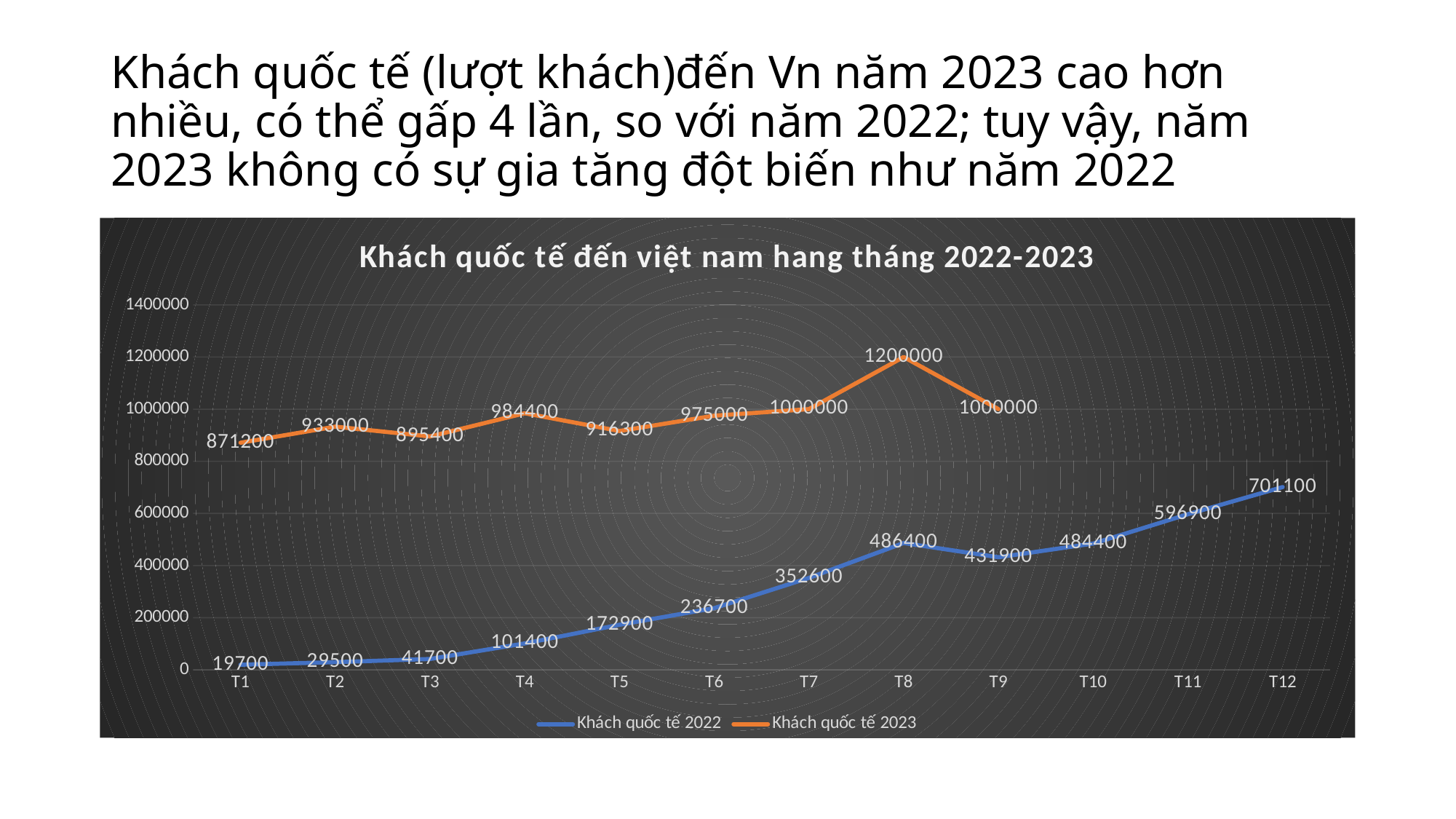
What is the value for Khách quốc tế 2022 in T12? 701100 Is the value for Khách quốc tế 2023 in T1 greater or less than 800000? greater Does Khách quốc tế 2022 generally rise or fall from T1 to T12? Rise What type of chart is shown on the slide? Line chart What is the value for Khách quốc tế 2023 in T4? 984400 What is the difference between Khách quốc tế 2023 and Khách quốc tế 2022 in T8? 713600 How many series does the legend list? 2 Which is larger: Khách quốc tế 2022 in T9 or in T10? T10 In which month does Khách quốc tế 2023 reach its highest value? T8 What is the title of the chart? Khách quốc tế đến việt nam hang tháng 2022-2023 How many months have a data point for Khách quốc tế 2023? 9 In which month is Khách quốc tế 2022 lowest? T1